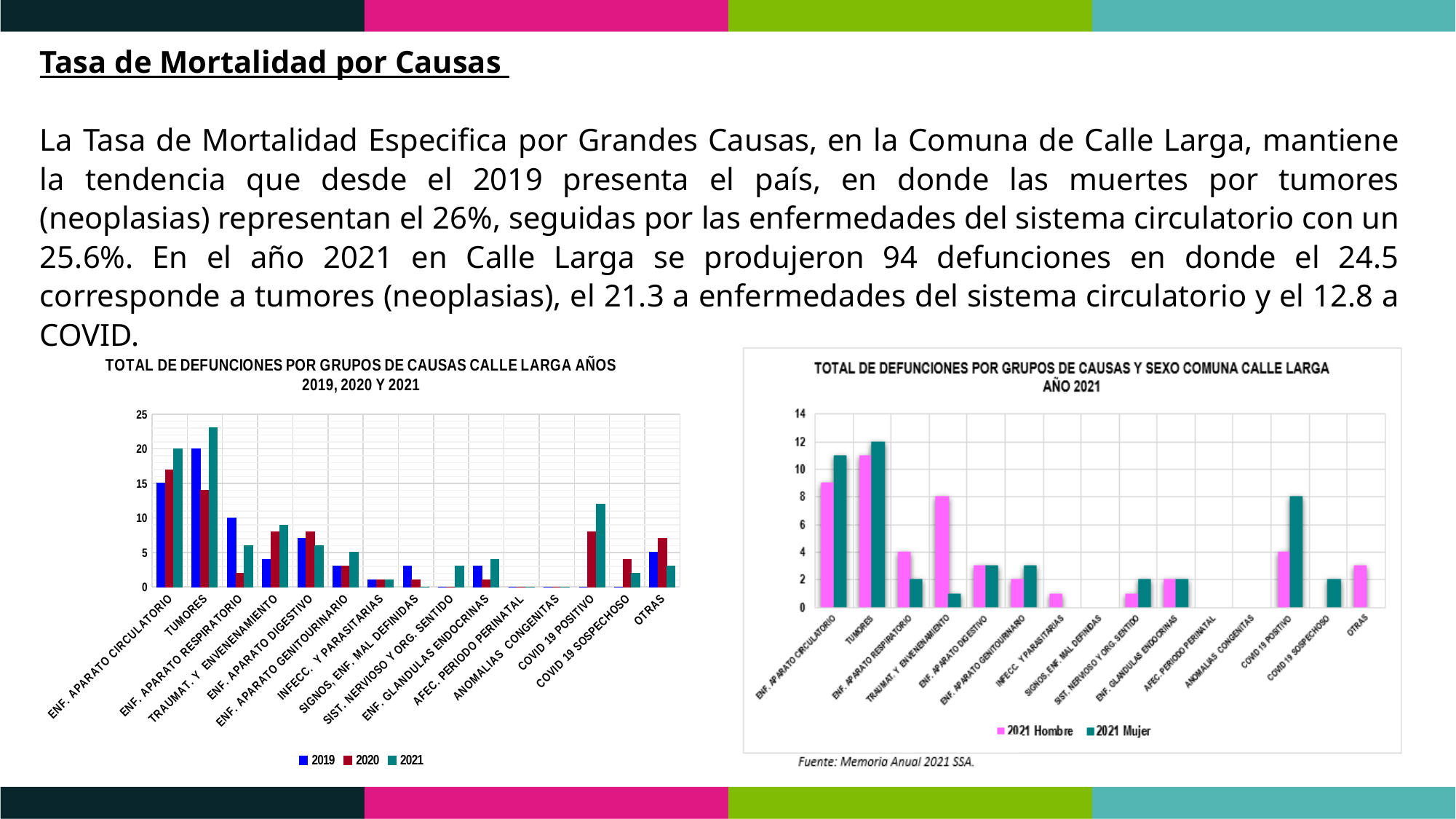
In the right chart (por grupos de causas y sexo, año 2021), what is the difference between 2021 Mujer and 2021 Hombre for COVID 19 POSITIVO? 4 In the right chart (por grupos de causas y sexo, año 2021), which is larger for COVID 19 POSITIVO: 2021 Hombre or 2021 Mujer? 2021 Mujer How many cause categories are shown on the x axis of the right chart (por grupos de causas y sexo, año 2021)? 15 In the left chart (años 2019, 2020 y 2021), is the value for 2021 in COVID 19 POSITIVO greater or less than 10? greater What kind of chart is the left chart, 'TOTAL DE DEFUNCIONES POR GRUPOS DE CAUSAS CALLE LARGA AÑOS 2019, 2020 Y 2021'? Bar chart In the right chart (por grupos de causas y sexo, año 2021), what is the value for 2021 Hombre in TRAUMAT. Y ENVENENAMIENTO? 8 In the right chart (por grupos de causas y sexo, año 2021), what is the value for 2021 Mujer in TUMORES? 12 How many series does the legend of the right chart (por grupos de causas y sexo, año 2021) list? 2 In the right chart (por grupos de causas y sexo, año 2021), which category has the highest value for 2021 Hombre? TUMORES In the left chart (años 2019, 2020 y 2021), what is the value for 2019 in TUMORES? 20 In the left chart (años 2019, 2020 y 2021), which category has the highest value for 2021? TUMORES How many series does the legend of the left chart (years 2019, 2020 y 2021) list? 3